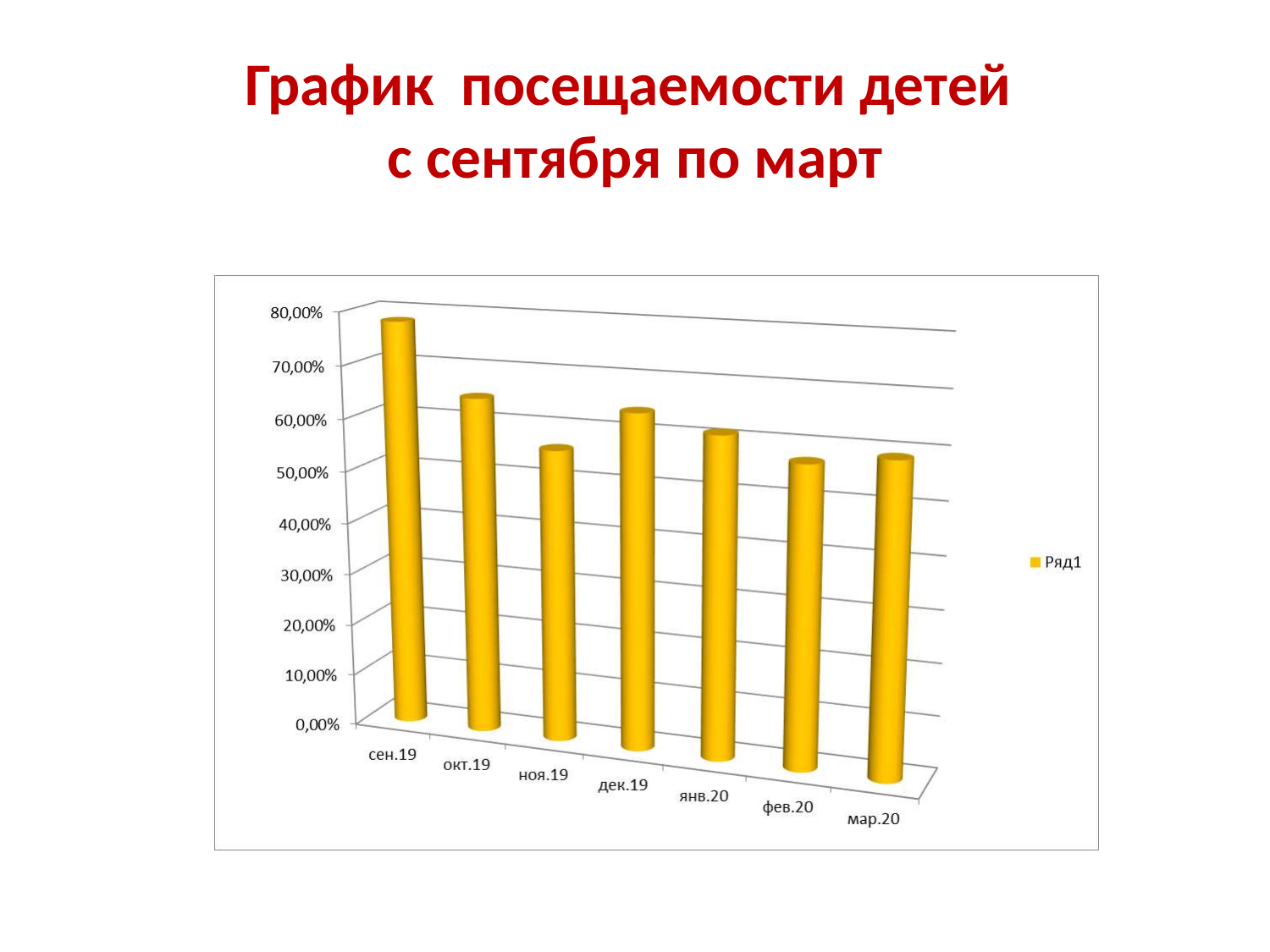
How many months (categories) are plotted on the chart? 7 Is the value for окт.19 greater or less than 50,00%? greater Which month has the highest attendance value? сен.19 Is the value for сен.19 greater or less than 60,00%? greater Is the value for ноя.19 greater or less than 70,00%? less How many series does the legend list? 1 Overall, do the values rise or fall from сен.19 to мар.20? fall Which is larger, the value for окт.19 or the value for фев.20? окт.19 Which is larger, the value for сен.19 or the value for ноя.19? сен.19 What is the name of the series shown in the legend? Ряд1 What kind of chart is shown on the slide? bar chart